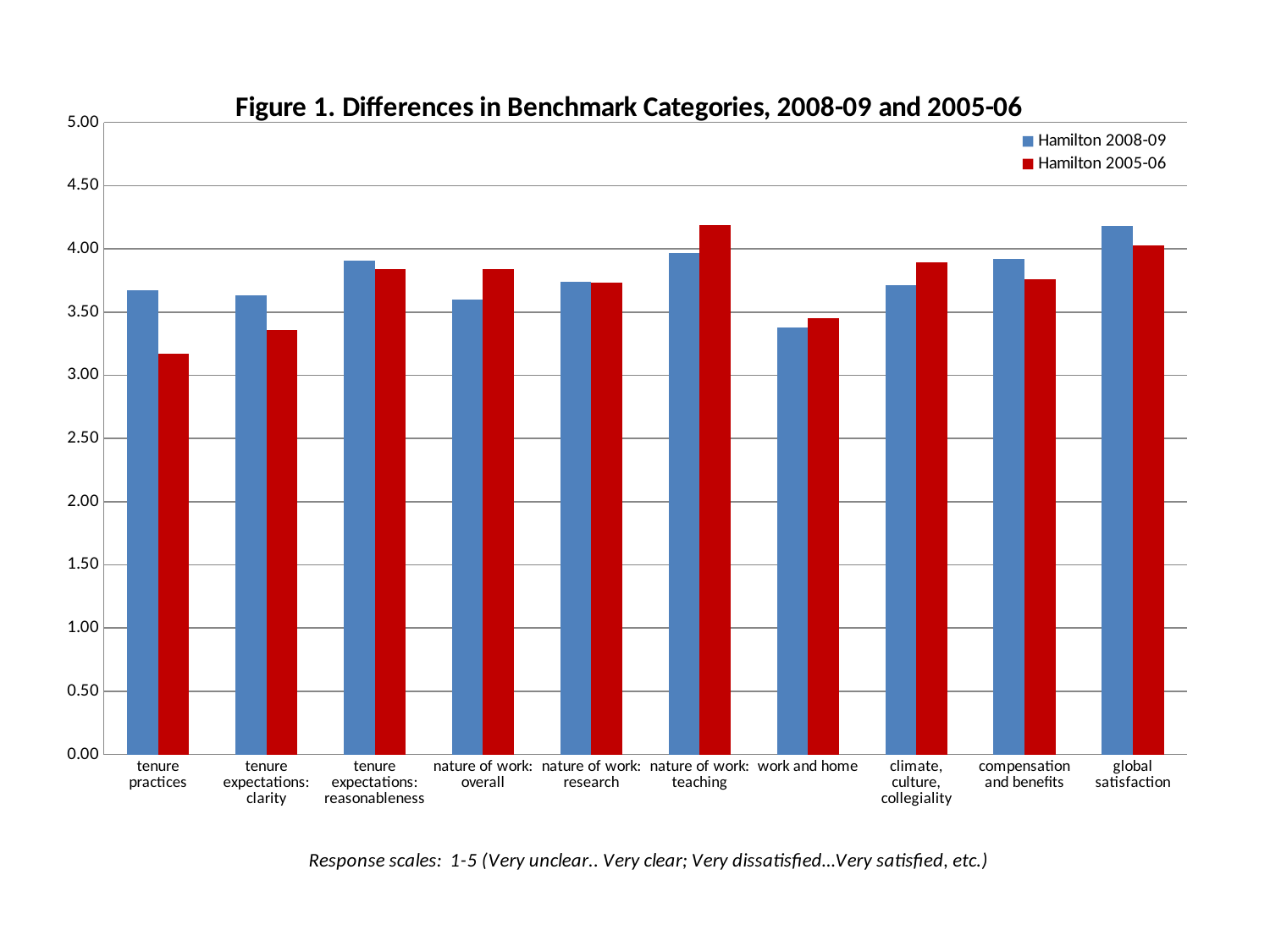
Is the Hamilton 2005-06 value for tenure practices greater or less than 3.50? less Which category has the highest value for Hamilton 2005-06? nature of work: teaching For tenure practices, which series has the larger value, Hamilton 2008-09 or Hamilton 2005-06? Hamilton 2008-09 How many series does the legend list? 2 Which category has the highest value for Hamilton 2008-09? global satisfaction Is the Hamilton 2008-09 value for global satisfaction greater or less than 4.00? greater How many benchmark categories are shown along the x axis? 10 What kind of chart is shown on the slide? bar chart Which category has the lowest value for Hamilton 2008-09? work and home Which category has the lowest value for Hamilton 2005-06? tenure practices For nature of work: teaching, which series has the larger value, Hamilton 2008-09 or Hamilton 2005-06? Hamilton 2005-06 What colour represents the Hamilton 2005-06 series? red